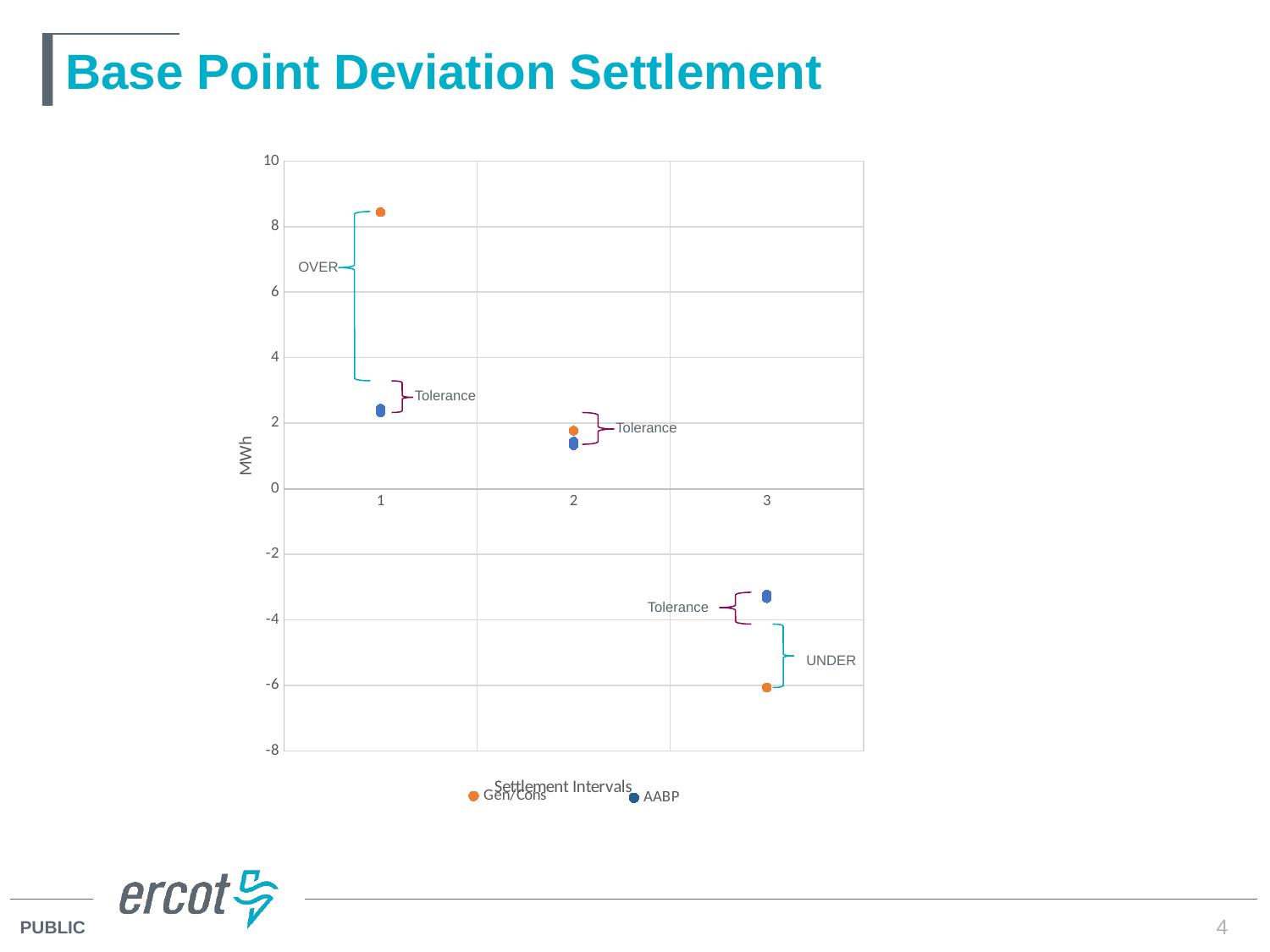
How many settlement intervals are plotted on the x axis? 3 Which settlement interval has the lowest AABP value? 3 What is the label on the y axis of the chart? MWh What kind of chart is shown on the slide? Scatter chart How many series does the legend list? 2 Is the AABP value for settlement interval 3 greater or less than -4? greater Is the Gen/Cons value for settlement interval 1 greater or less than 6? greater Is the Gen/Cons value for settlement interval 3 greater or less than -4? less Which settlement interval has the highest Gen/Cons value? 1 At settlement interval 1, which series has the larger value, Gen/Cons or AABP? Gen/Cons Which settlement interval has the lowest Gen/Cons value? 3